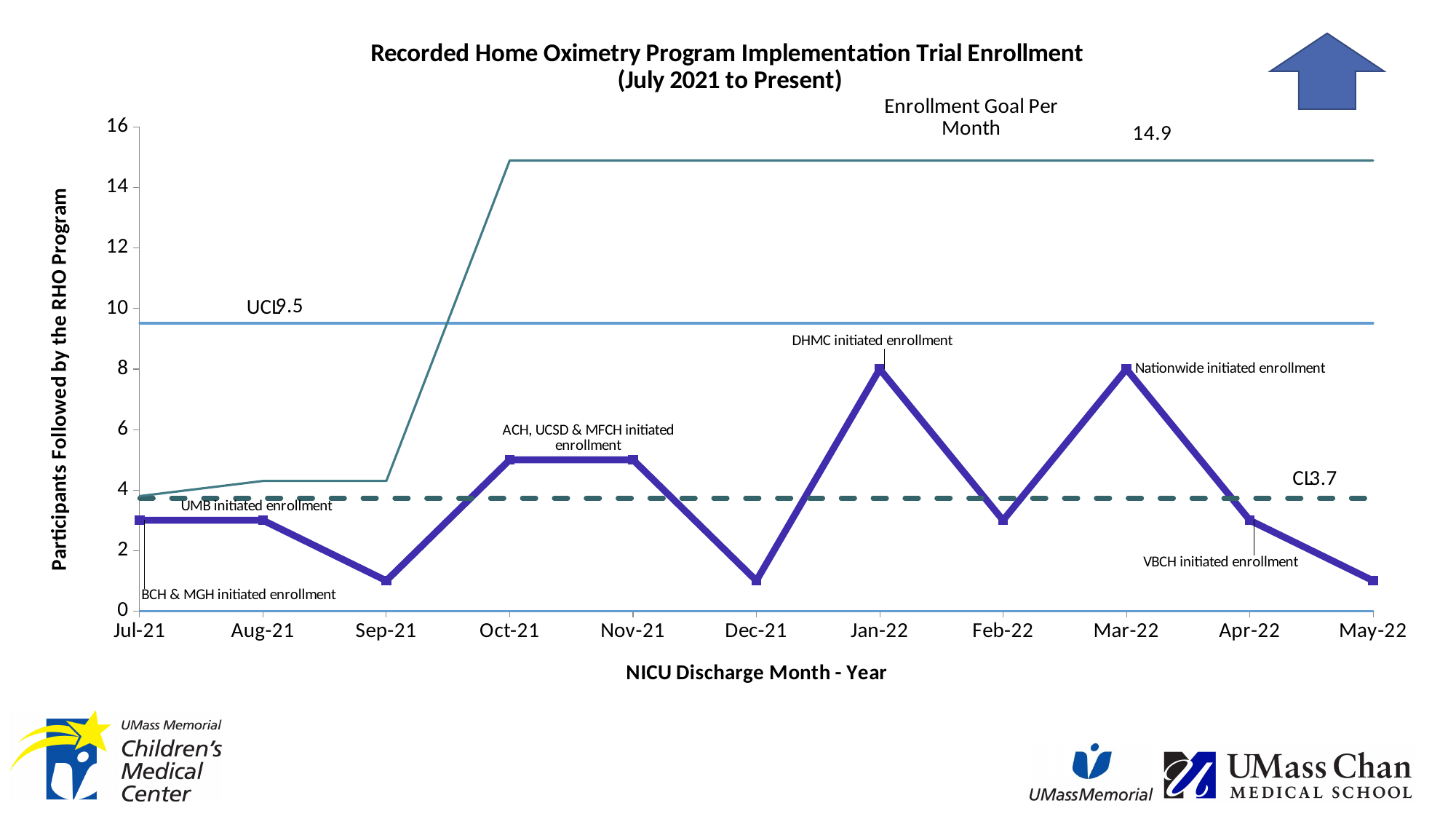
What is the number of participants followed by the RHO program for Jan-22? 8 What is the labelled value of the Enrollment Goal Per Month line? 14.9 How many months are shown on the x axis? 11 Is the value for Oct-21 greater or less than 4? greater What kind of chart is this? line chart Is the value for Sep-21 greater or less than 2? less What is the difference between the UCL value and the CL value? 5.8 What is the number of participants followed by the RHO program for Mar-22? 8 What value is labelled for the UCL line? 9.5 What value is labelled for the CL line? 3.7 Which month has the larger value, Jan-22 or Feb-22? Jan-22 What is the title of the x axis? NICU Discharge Month - Year